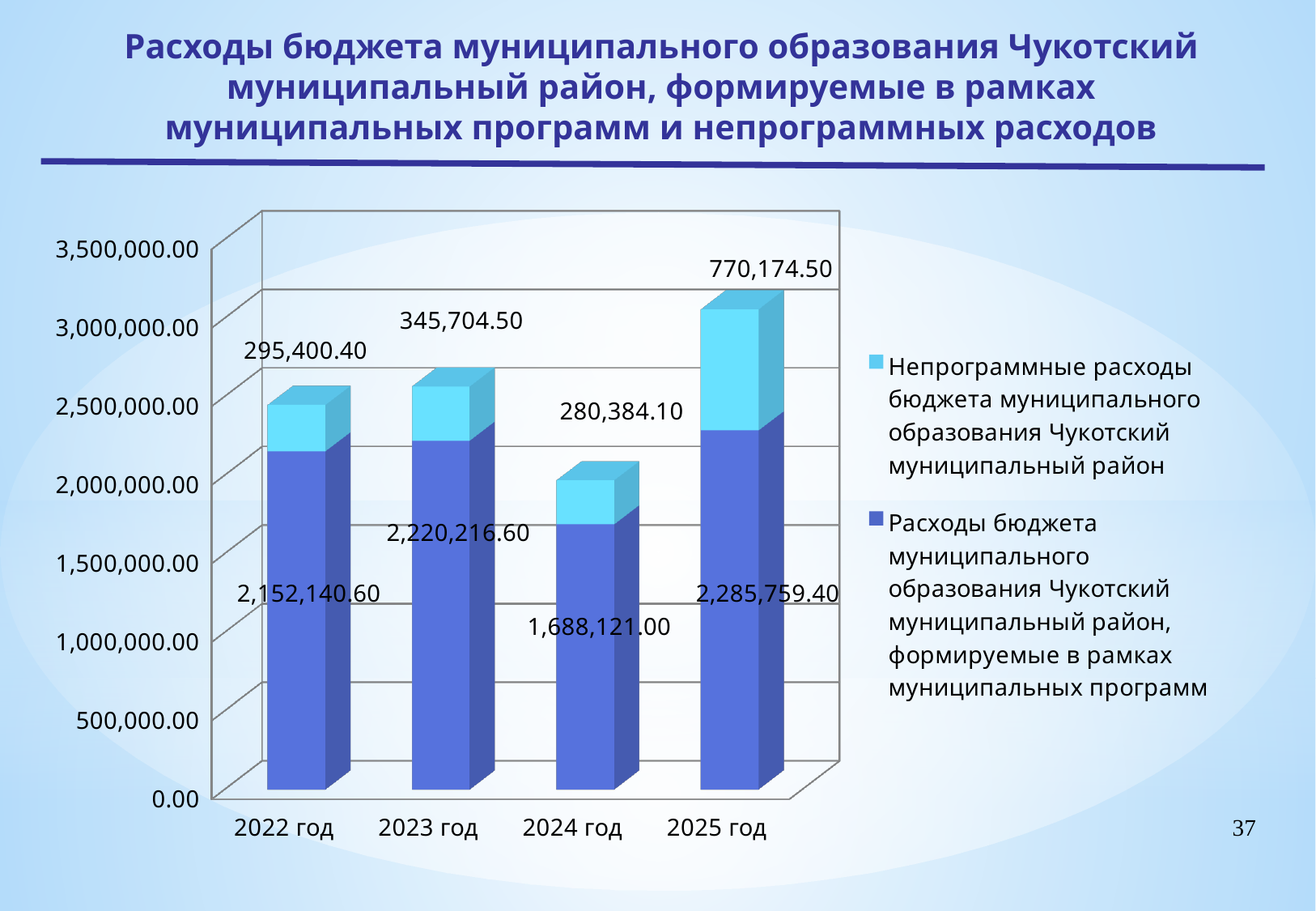
What is the total of the stacked bar for 2024 год? 1,968,505.10 What is the value of the program expenditures (Расходы бюджета ... формируемые в рамках муниципальных программ) for 2024 год? 1,688,121.00 Which is larger: the program expenditures in 2023 год or in 2022 год? 2023 год What is the total of the stacked bar for 2025 год? 3,055,933.90 What is the difference between the non-program expenditures in 2025 год and 2023 год? 424,470.00 What is the value of the non-program expenditures (Непрограммные расходы) for 2025 год? 770,174.50 Which year has the lowest non-program expenditures (light blue series)? 2024 год What is the value of the non-program expenditures for 2022 год? 295,400.40 How many years (categories) are shown on the x axis? 4 What kind of chart is shown on the slide? Stacked bar chart Which year has the highest program expenditures (dark blue series)? 2025 год How many series does the legend list? 2